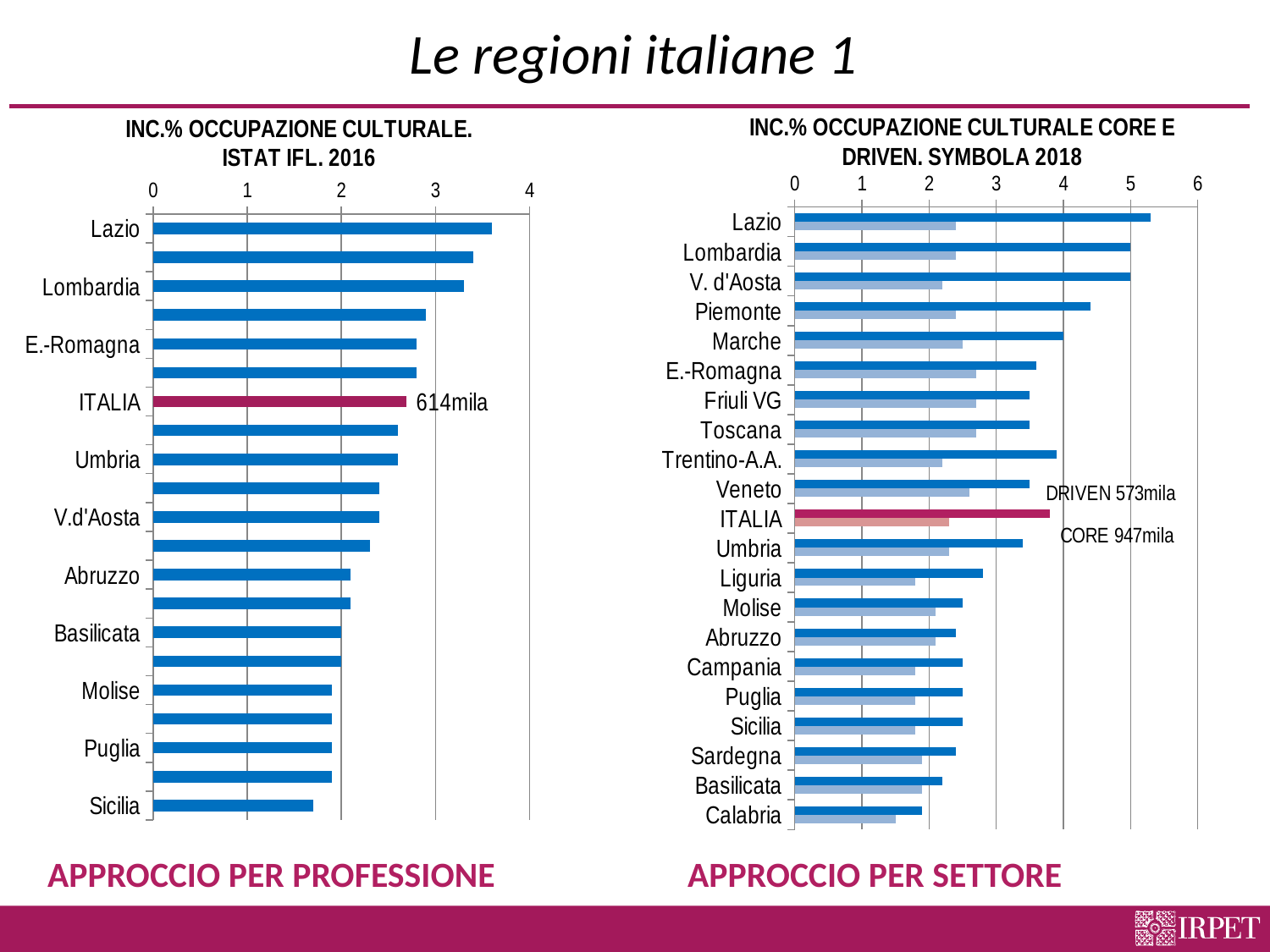
What kind of chart is the left chart, 'INC.% OCCUPAZIONE CULTURALE. ISTAT IFL. 2016'? bar chart In the left chart (ISTAT IFL. 2016), what label is printed next to the highlighted ITALIA bar? 614mila In the right chart (SYMBOLA 2018), which region has the shortest bars? Calabria In the right chart (SYMBOLA 2018), which has the longer bar, Piemonte or Umbria? Piemonte In the right chart (SYMBOLA 2018), which region has the longest bar? Lazio In the left chart (ISTAT IFL. 2016), which has the larger value, Lombardia or Umbria? Lombardia In the left chart (ISTAT IFL. 2016), is the value for Lazio greater or less than 3? greater In the left chart (ISTAT IFL. 2016), which labelled region has the lowest value? Sicilia In the left chart (ISTAT IFL. 2016), which region has the highest value? Lazio In the right chart (SYMBOLA 2018), is the longer bar for Lazio greater or less than 4? greater In the left chart (ISTAT IFL. 2016), is the value for Sicilia greater or less than 2? less How many categories (regions plus ITALIA) are listed on the right chart (SYMBOLA 2018)? 21